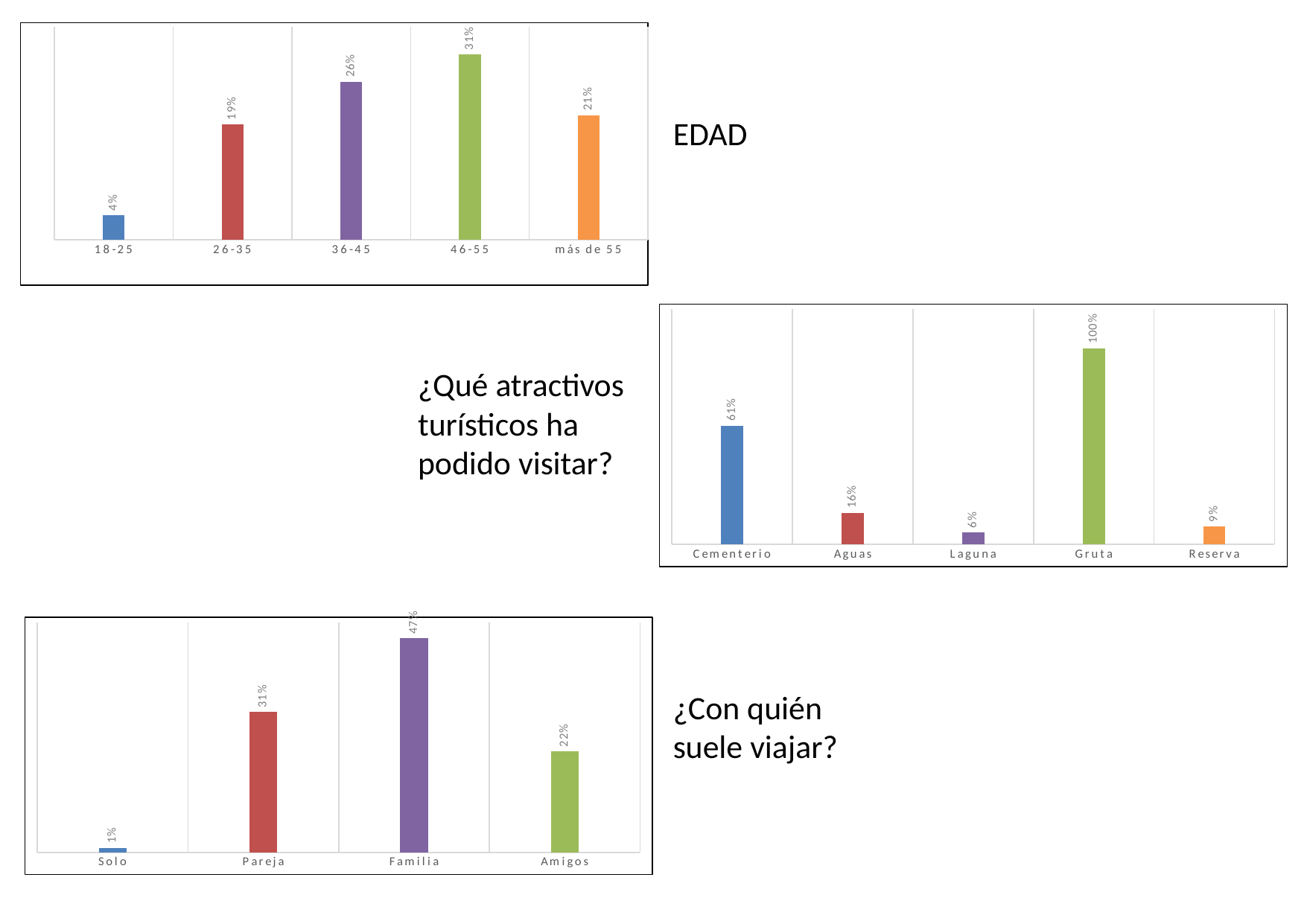
In the EDAD chart, how many age groups are shown? 5 In the '¿Con quién suele viajar?' chart, what is the difference between the values for Familia and Amigos? 25% In the '¿Qué atractivos turísticos ha podido visitar?' chart, what is the value for Cementerio? 61% In the '¿Qué atractivos turísticos ha podido visitar?' chart, which attraction has the highest value? Gruta In the '¿Qué atractivos turísticos ha podido visitar?' chart, which attraction has the lowest value? Laguna In the EDAD chart, which age group has the highest value? 46-55 In the EDAD chart, what is the value for the 36-45 age group? 26% In the EDAD chart, what is the difference between the values for 46-55 and 26-35? 12% In the '¿Con quién suele viajar?' chart, what is the value for Pareja? 31% What type of chart is the '¿Con quién suele viajar?' chart? Bar chart In the '¿Qué atractivos turísticos ha podido visitar?' chart, which is larger, the value for Aguas or the value for Reserva? Aguas In the EDAD chart, which age group has the lowest value? 18-25